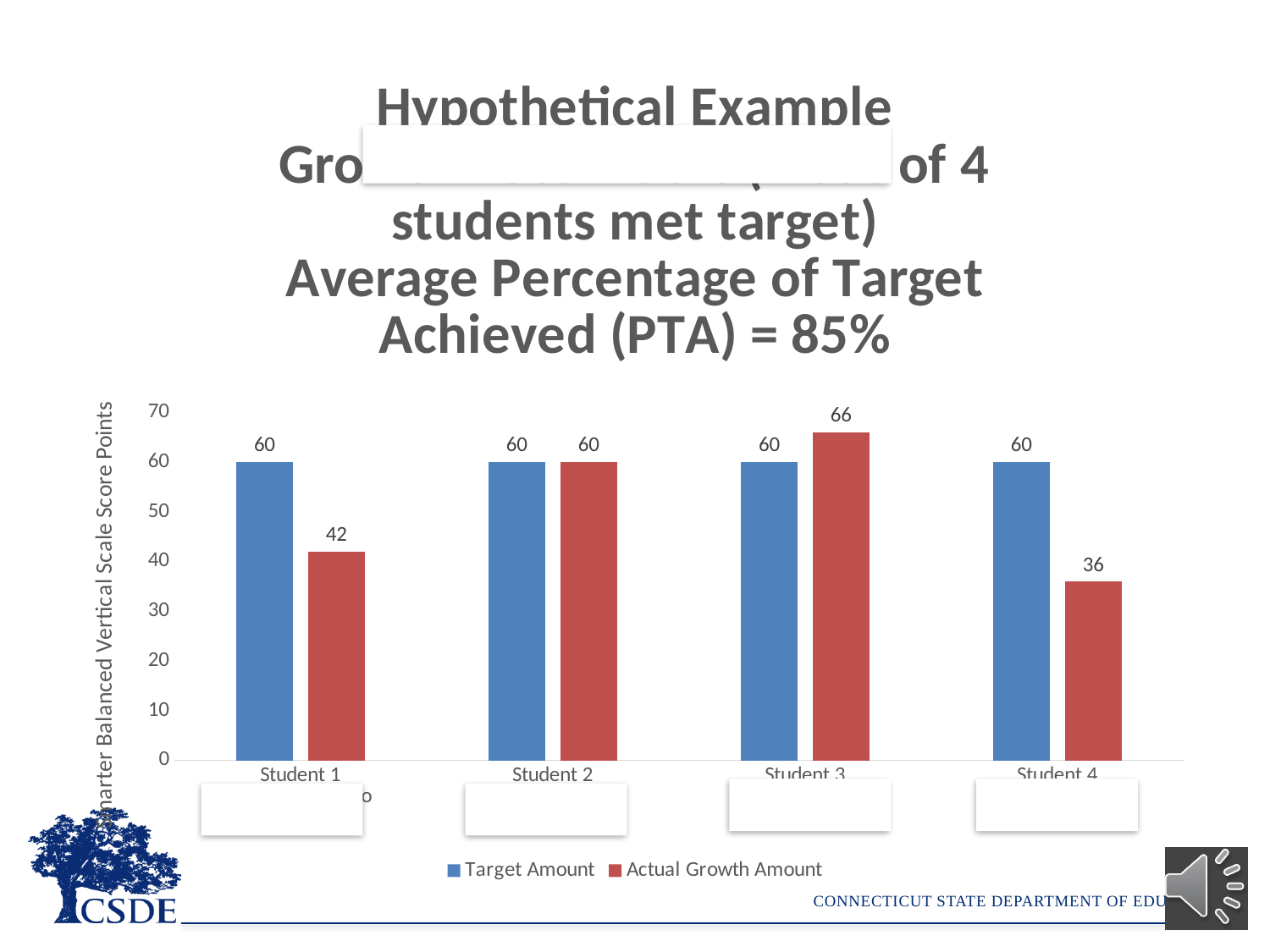
What is the label of the y axis of the chart? Smarter Balanced Vertical Scale Score Points What kind of chart is shown on the slide? Bar chart How many series does the chart legend list? 2 What is the Actual Growth Amount for Student 1? 42 How many students are shown on the x axis of the chart? 4 Which is larger for Student 3, the Target Amount or the Actual Growth Amount? Actual Growth Amount What is the difference between the Target Amount and the Actual Growth Amount for Student 1? 18 Which student has the lowest Actual Growth Amount? Student 4 What is the Actual Growth Amount for Student 4? 36 What is the Target Amount for Student 3? 60 What is the difference between the Actual Growth Amount for Student 3 and Student 4? 30 Which student has the highest Actual Growth Amount? Student 3